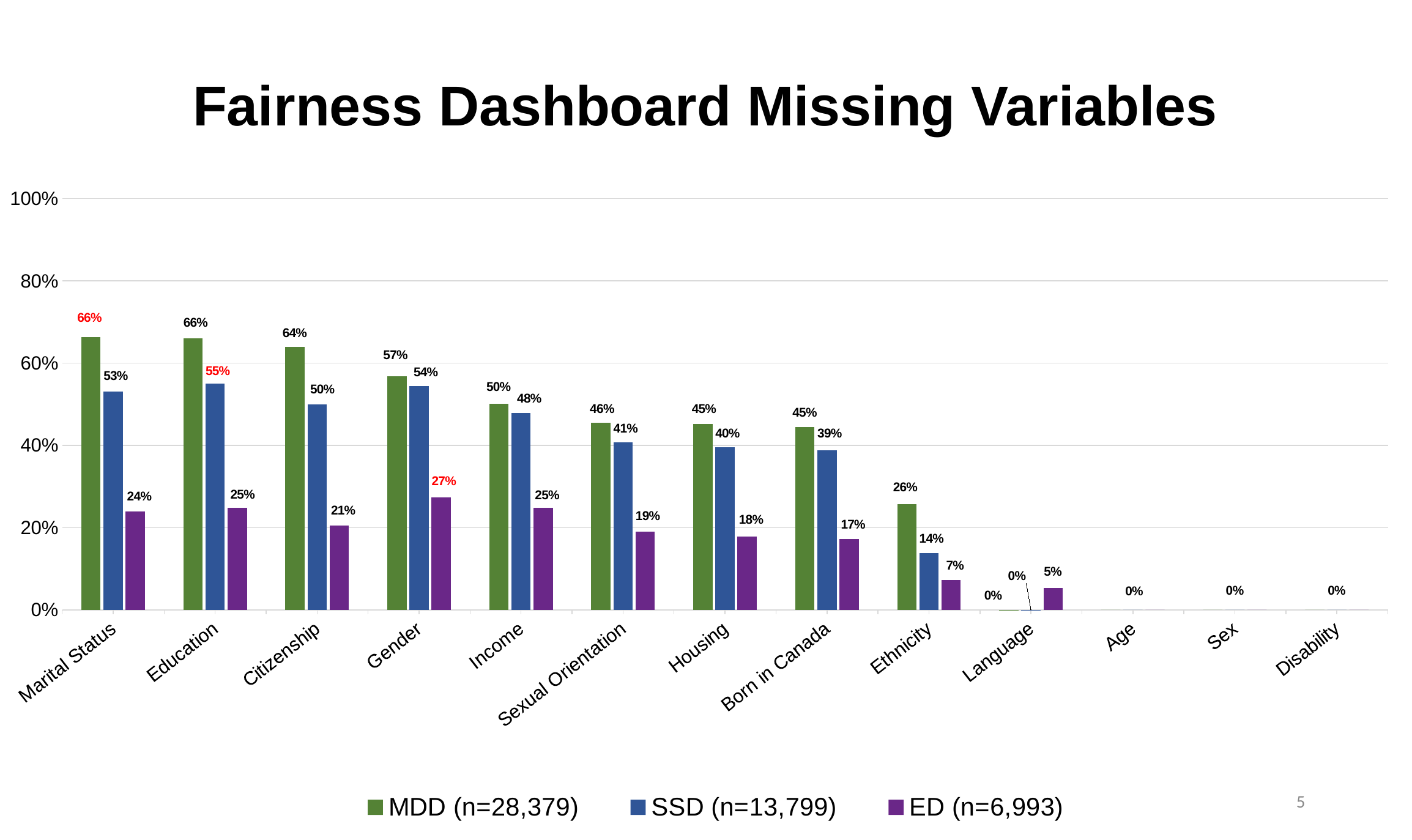
How many categories are shown on the x axis? 13 What is the difference between the MDD (n=28,379) and SSD (n=13,799) values for Ethnicity? 12% What kind of chart is shown on the slide? bar chart What is the SSD (n=13,799) value for Gender? 54% What is the title of the chart? Fairness Dashboard Missing Variables Do the MDD (n=28,379) values generally rise or fall from Marital Status to Disability along the x axis? fall What is the ED (n=6,993) value for Born in Canada? 17% How many series does the legend list? 3 What is the MDD (n=28,379) value for Citizenship? 64% Is the SSD (n=13,799) value for Housing greater or less than 60%? less Which is larger for Income: the MDD (n=28,379) value or the SSD (n=13,799) value? MDD (n=28,379) Which category has the highest ED (n=6,993) value? Gender